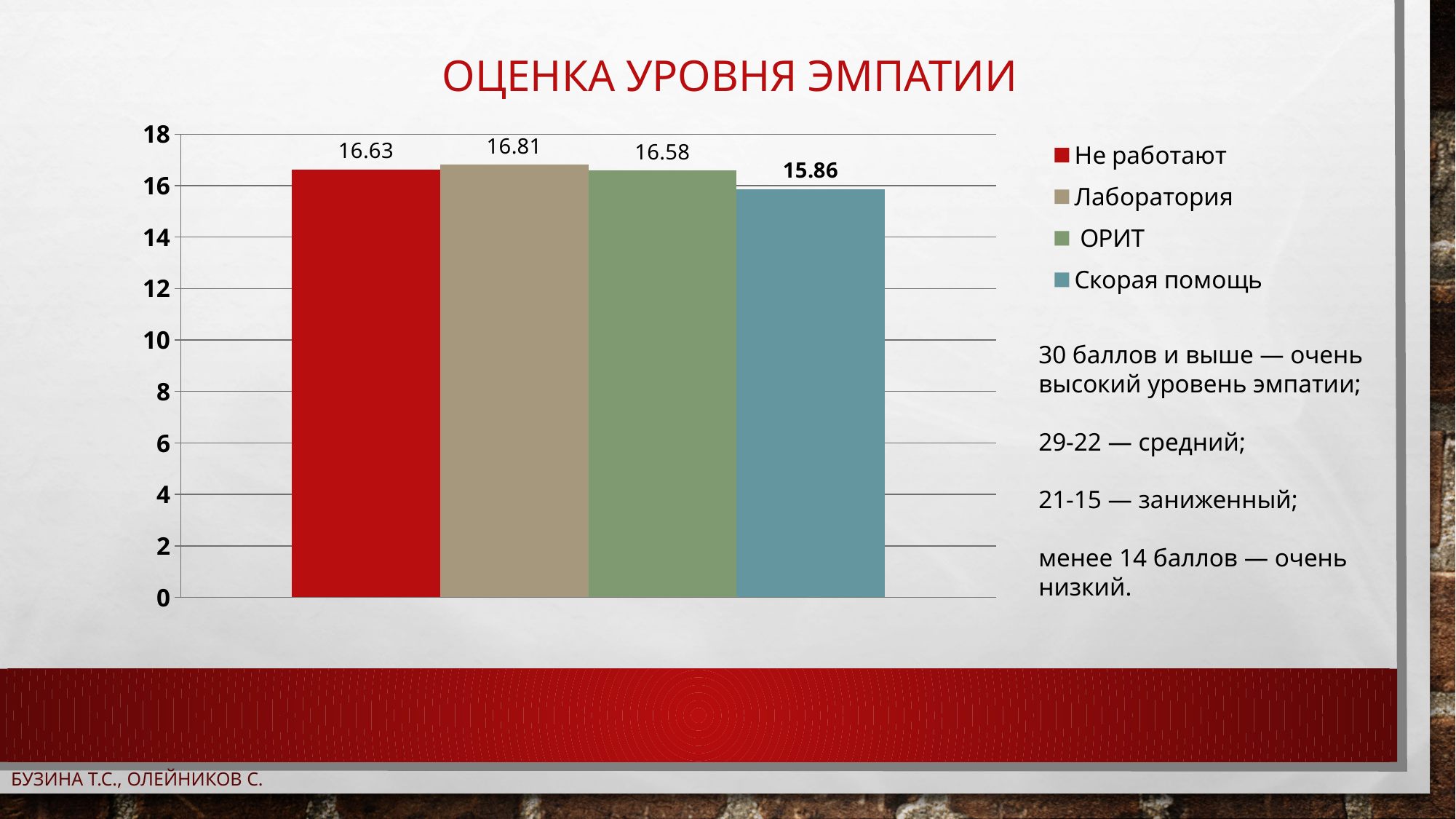
Which series has the lowest value? Скорая помощь What kind of chart is shown on the slide? bar chart Which series has the highest value? Лаборатория What is the difference between the values for Не работают and ОРИТ? 0.05 What is the value for ОРИТ? 16.58 How many series does the legend list? 4 What is the value for Скорая помощь? 15.86 Which is larger, the value for Не работают or the value for Скорая помощь? Не работают What is the value for Лаборатория? 16.81 Is the value for Скорая помощь greater or less than 16? less What is the difference between the values for Лаборатория and Скорая помощь? 0.95 What is the value for Не работают? 16.63